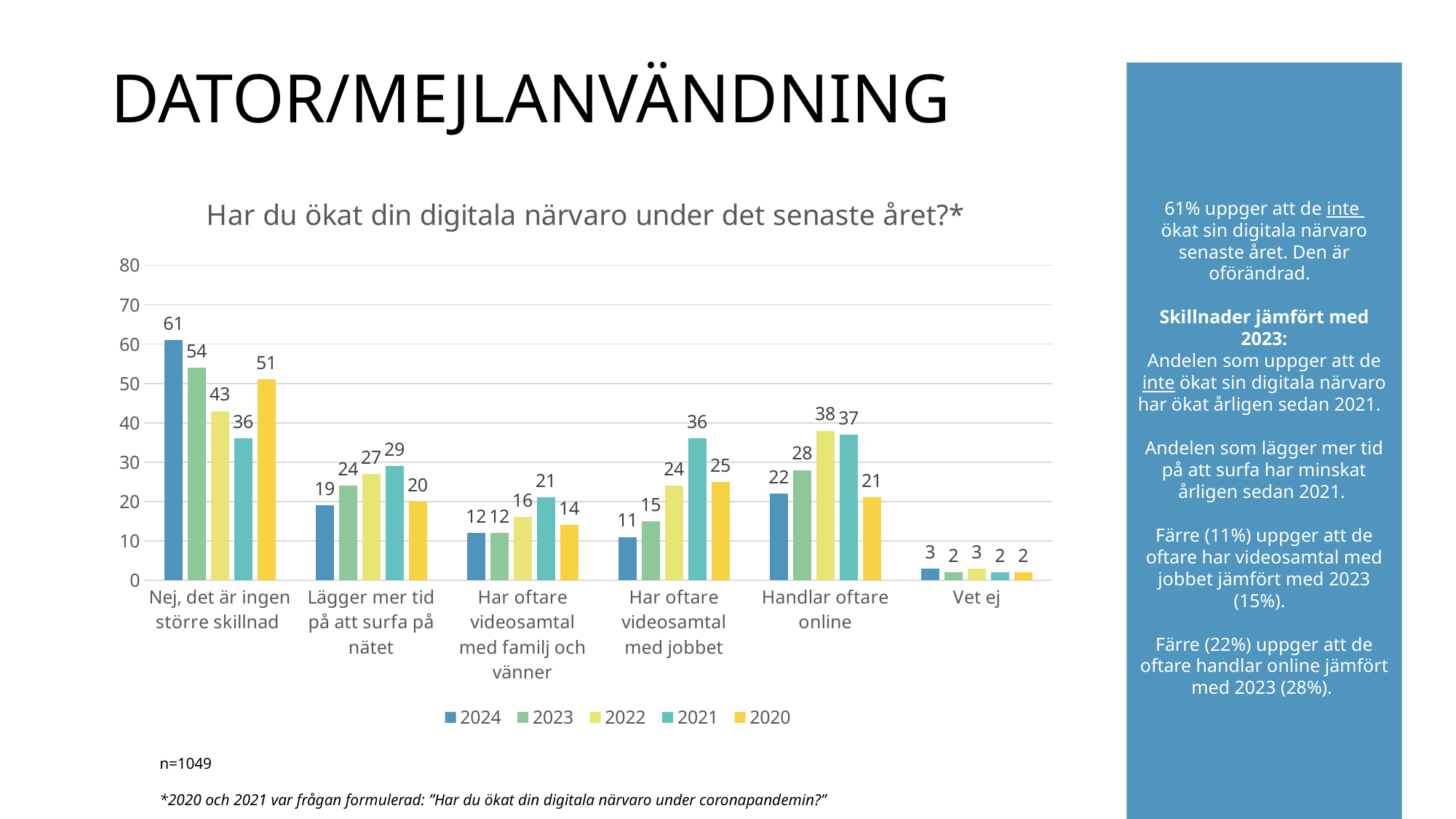
How many series does the legend list? 5 What is the value for 2022 in the category "Handlar oftare online"? 38 Which category has the highest value for the 2024 series? Nej, det är ingen större skillnad How many categories are shown on the x axis? 6 Which category has the lowest value for the 2023 series? Vet ej What is the title of the chart? Har du ökat din digitala närvaro under det senaste året?* Which series is shown in yellow in the legend? 2020 What is the value for 2021 in the category "Har oftare videosamtal med jobbet"? 36 What kind of chart is shown on the slide? Bar chart What is the value for 2024 in the category "Nej, det är ingen större skillnad"? 61 Which is larger for "Lägger mer tid på att surfa på nätet": the 2021 value or the 2020 value? 2021 What is the difference between the 2024 and 2023 values for "Handlar oftare online"? 6